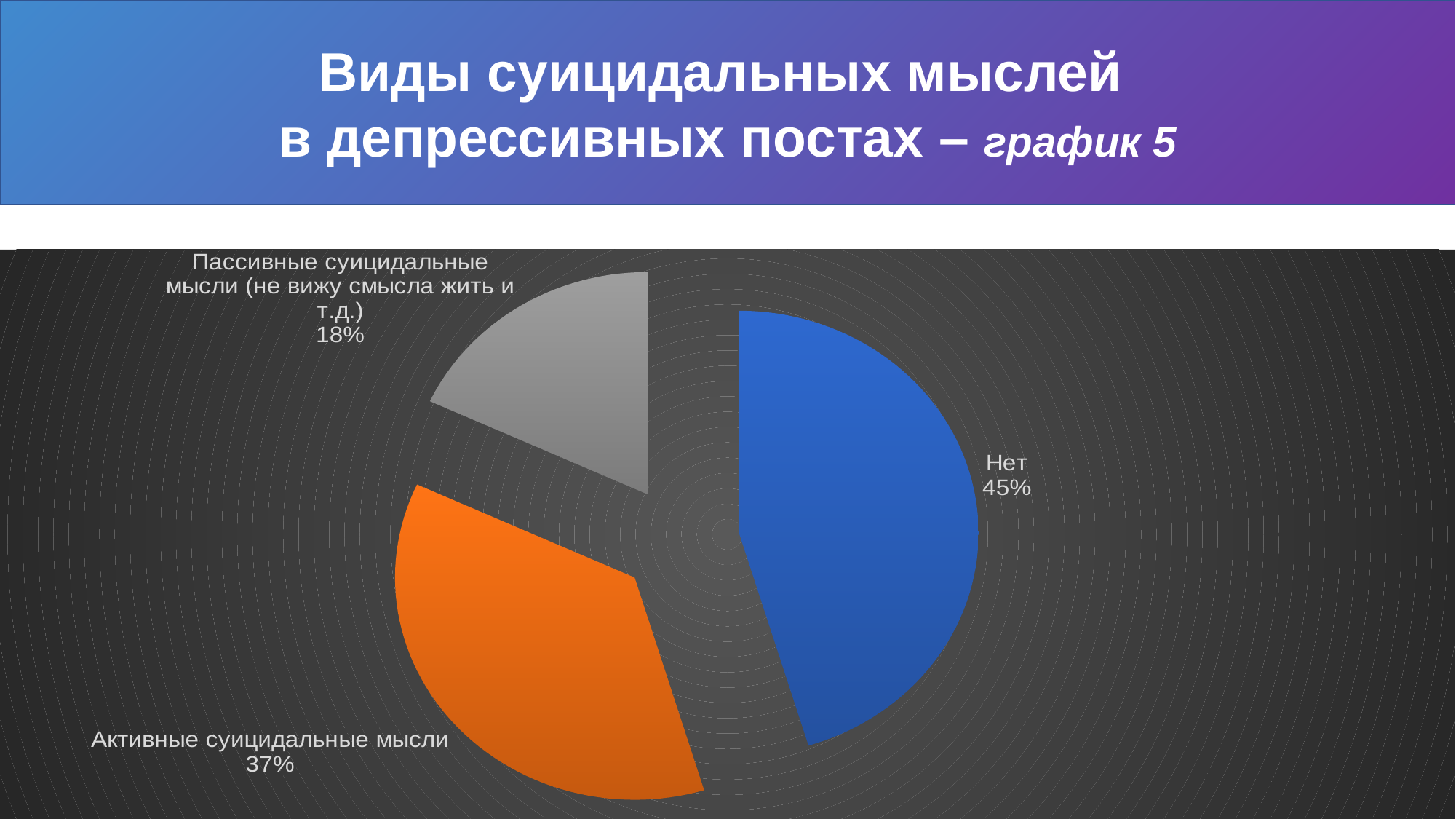
What is the title of the slide? Виды суицидальных мыслей в депрессивных постах – график 5 What colour is the "Нет" slice? Blue What share of the pie does the "Нет" slice represent? 45% Which category has the smallest slice of the pie? Пассивные суицидальные мысли (не вижу смысла жить и т.д.) What is the difference in percentage points between the "Нет" slice and the "Активные суицидальные мысли" slice? 8 What share of the pie does the "Активные суицидальные мысли" slice represent? 37% What kind of chart is shown on the slide? Pie chart Which category has the largest slice of the pie? Нет Which is larger: the "Активные суицидальные мысли" slice or the "Пассивные суицидальные мысли" slice? Активные суицидальные мысли What is the difference in percentage points between the "Активные суицидальные мысли" slice and the "Пассивные суицидальные мысли" slice? 19 What share of the pie does the "Пассивные суицидальные мысли (не вижу смысла жить и т.д.)" slice represent? 18% How many slices does the pie chart have? 3